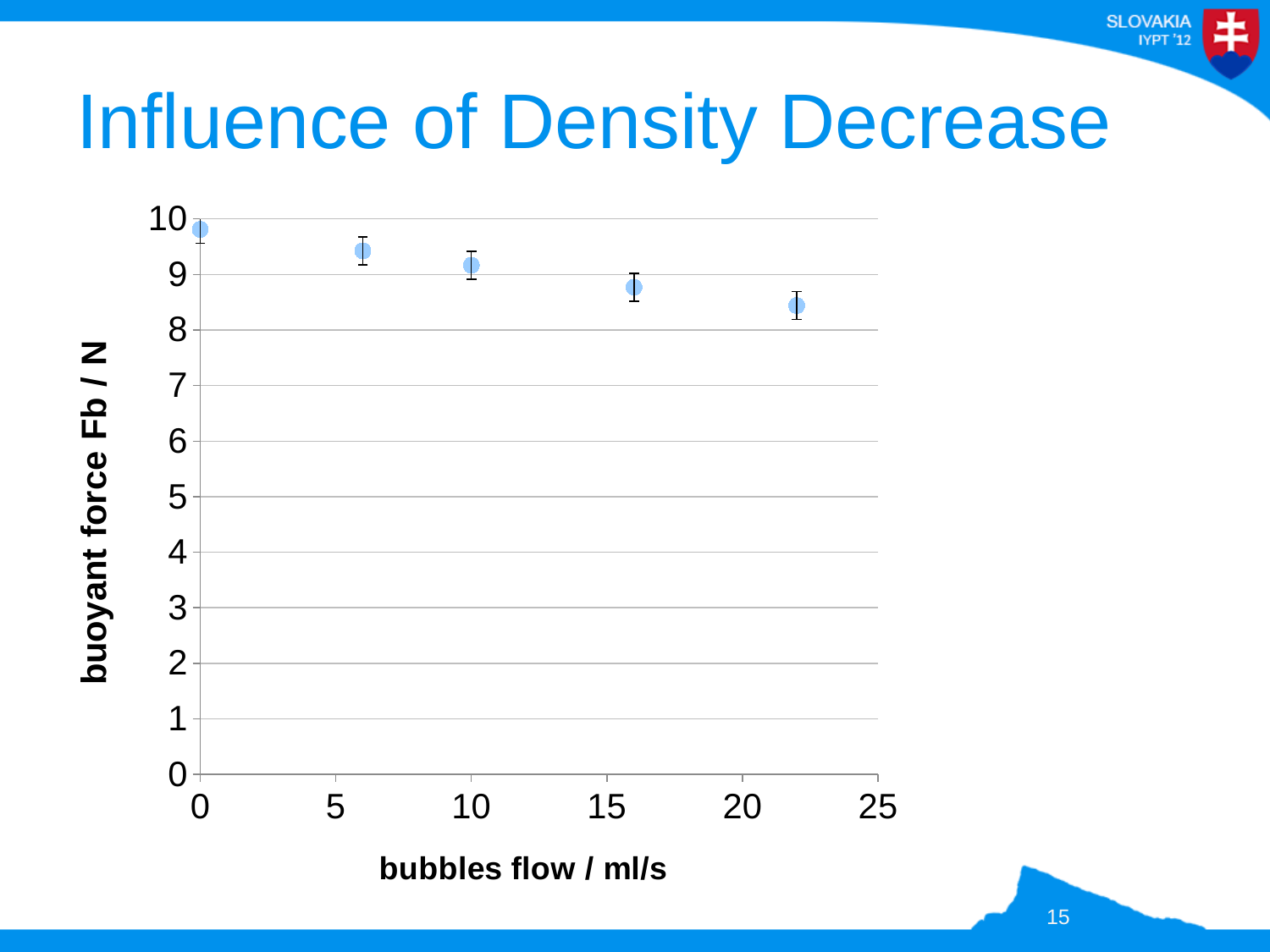
What is the label of the vertical axis? buoyant force Fb / N Is the buoyant force at a bubbles flow of 22 ml/s greater or less than 8 N? greater Which has the larger buoyant force: the point at 0 ml/s or the point at 22 ml/s? 0 ml/s At which bubbles flow value is the buoyant force highest? 0 ml/s What kind of chart is shown on the slide? scatter plot Is the buoyant force at a bubbles flow of 22 ml/s greater or less than 9 N? less What is the label of the horizontal axis? bubbles flow / ml/s Is the buoyant force at a bubbles flow of 6 ml/s greater or less than 9 N? greater How many data points are plotted on the chart? 5 Do the buoyant force values rise or fall as the bubbles flow increases? fall At which bubbles flow value is the buoyant force lowest? 22 ml/s